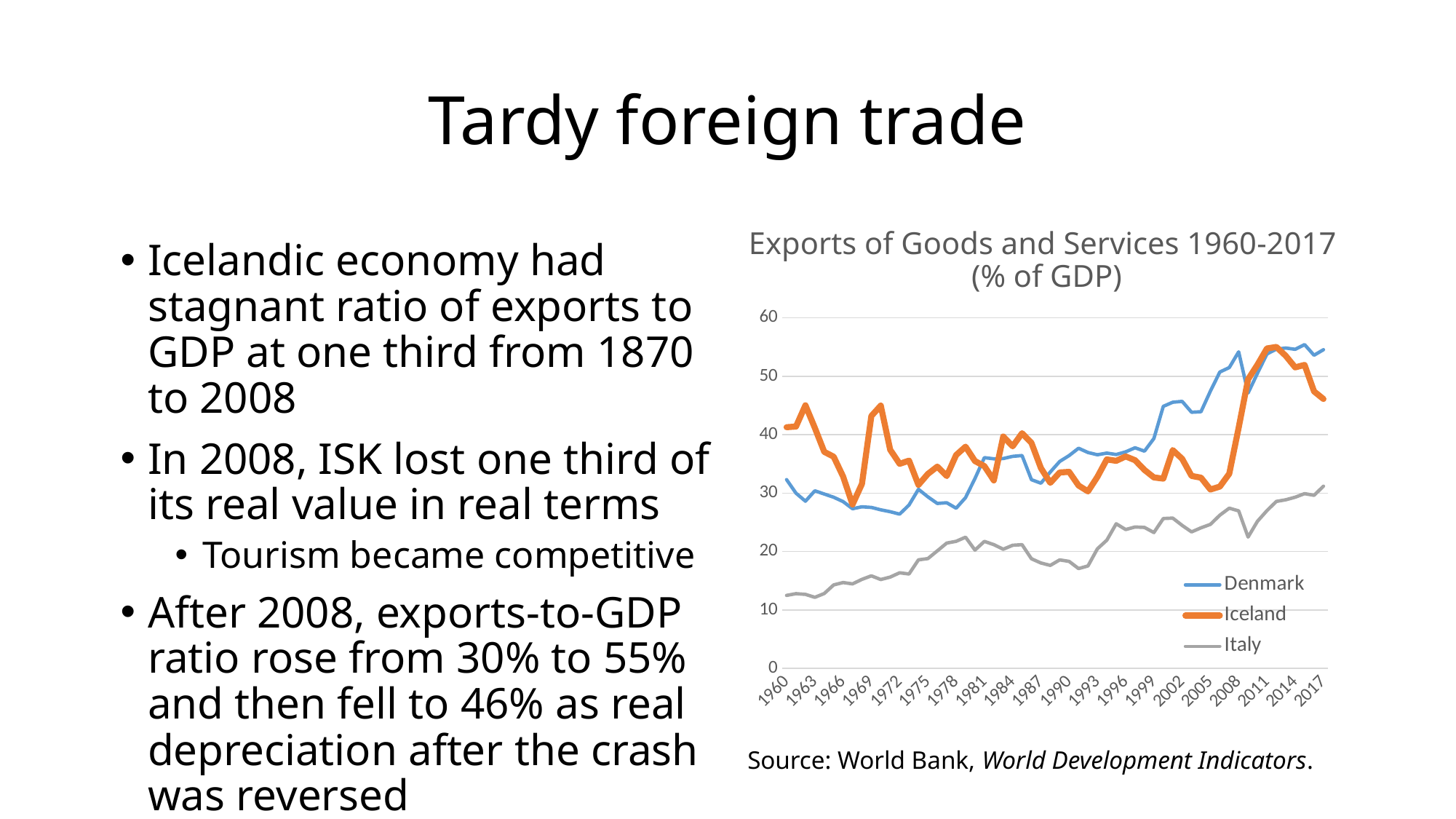
Is the value for Italy in 1960 greater or less than 20? less What is the title of the chart? Exports of Goods and Services 1960-2017 (% of GDP) In 2017, which is larger: the value for Iceland or the value for Italy? Iceland Is the value for Italy in 2017 greater or less than 20? greater Which country has the lowest exports-to-GDP ratio across the whole period shown? Italy Is the value for Iceland in 1960 greater or less than 30? greater What kind of chart is shown on the slide? line chart How many series does the chart legend list? 3 Which colour is used for the Iceland line in the chart? orange In 1960, which is larger: the value for Denmark or the value for Italy? Denmark